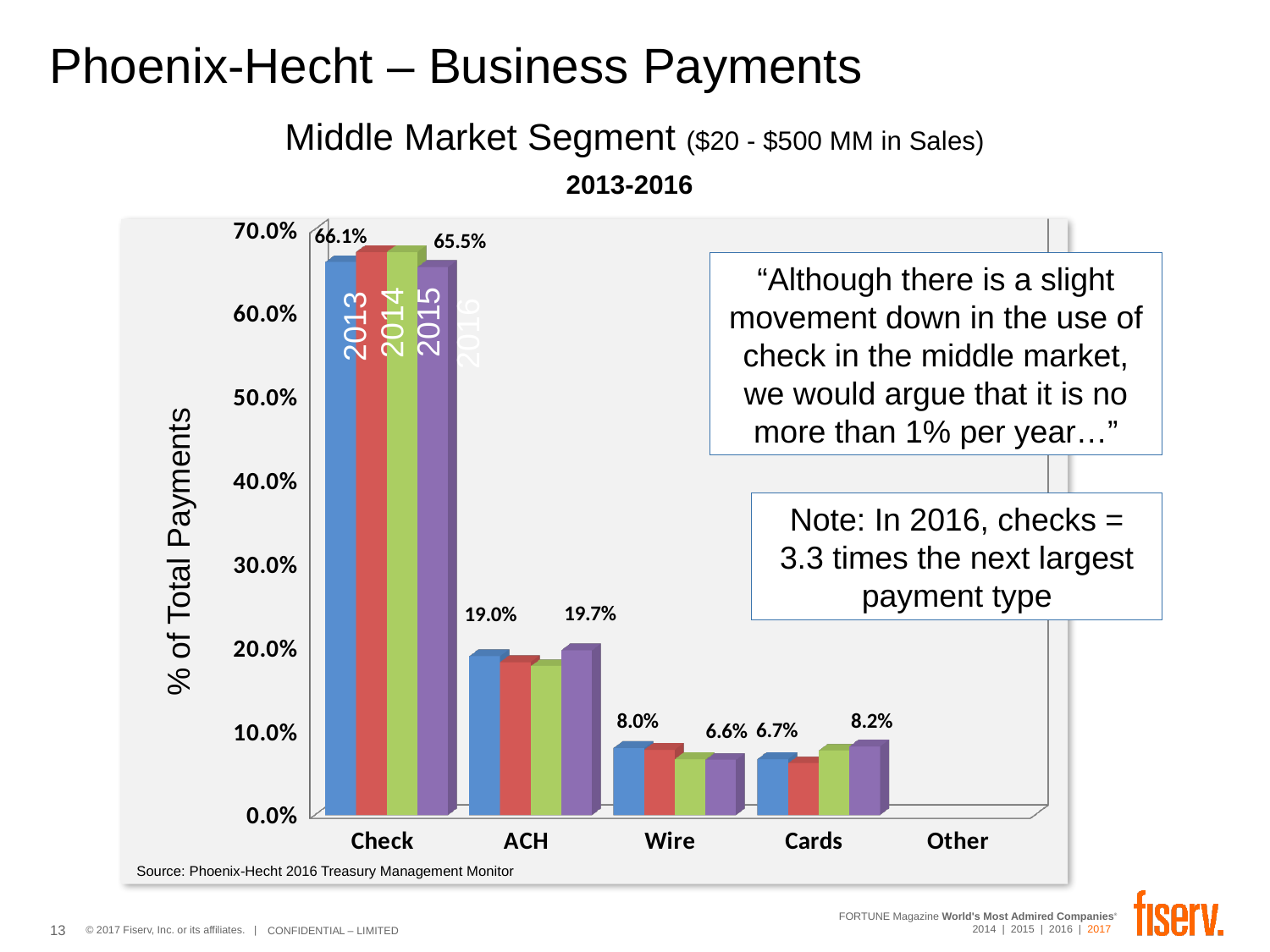
What is the value for Wire in 2013? 8.0% What is the value for ACH in 2016? 19.7% How many payment type categories are shown on the x axis? 5 Which payment type has the highest share of total payments? Check What is the value for Cards in 2016? 8.2% What kind of chart is shown on the slide? bar chart Is the value for Check in 2014 greater or less than 60.0%? greater What is the value for Check in 2016? 65.5% What is the value for Check in 2013? 66.1% By how much did the ACH value in 2016 exceed the ACH value in 2013? 0.7% Which is larger in 2013, the value for Wire or the value for Cards? Wire What is the difference between the Check value in 2013 and in 2016? 0.6%